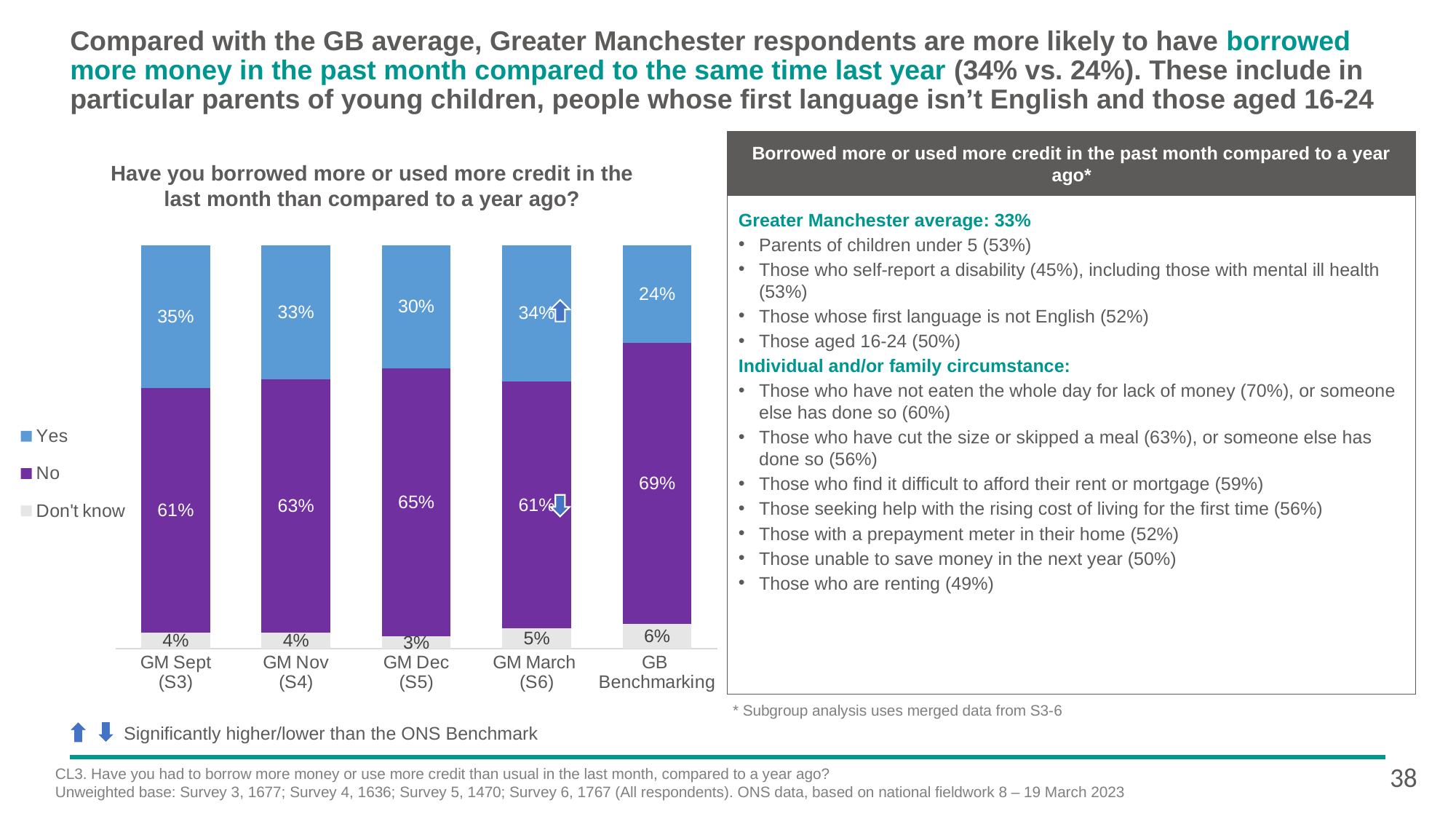
How many series does the chart legend list? 3 What is the 'Yes' value for GM Sept (S3)? 35% Which is larger: the 'No' value for GM Nov (S4) or the 'No' value for GM Dec (S5)? GM Dec (S5) What kind of chart is shown on the slide? Stacked bar chart What is the total of the stacked bar for GM March (S6)? 100% What is the 'No' value for GB Benchmarking? 69% What is the difference between the 'Yes' value for GM March (S6) and the 'Yes' value for GB Benchmarking? 10% What is the 'Don't know' value for GM Dec (S5)? 3% How many categories are shown along the x axis of the chart? 5 Which category has the lowest 'Yes' value? GB Benchmarking What is the title of the chart? Have you borrowed more or used more credit in the last month than compared to a year ago? Which category has the highest 'Yes' value? GM Sept (S3)